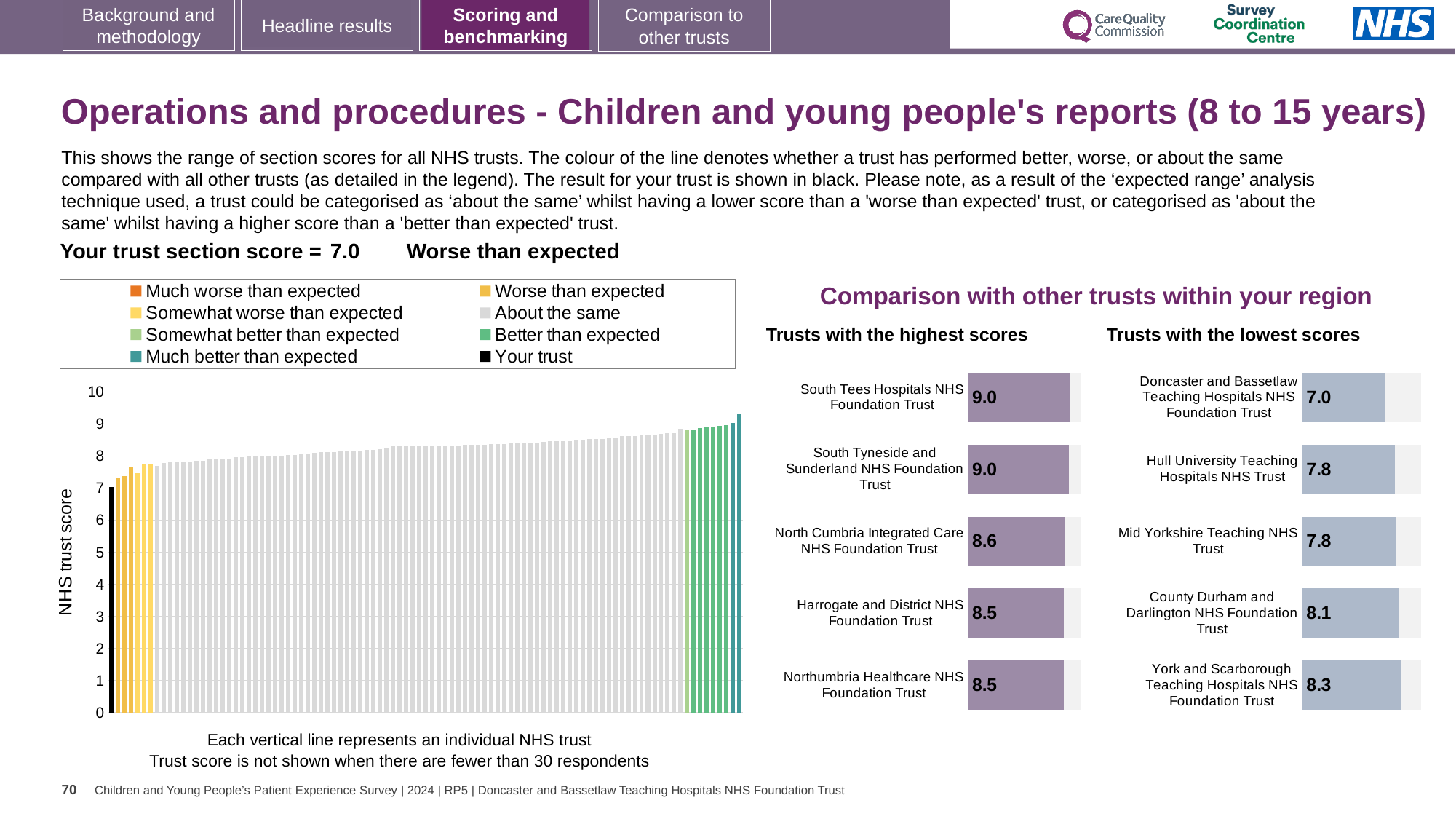
In the large chart on the left, do the trust scores rise or fall from left to right? rise In the 'Trusts with the highest scores' chart, what is the difference between the scores of South Tees Hospitals NHS Foundation Trust and North Cumbria Integrated Care NHS Foundation Trust? 0.4 Which is larger: the score for Harrogate and District NHS Foundation Trust in the 'Trusts with the highest scores' chart or the score for Hull University Teaching Hospitals NHS Trust in the 'Trusts with the lowest scores' chart? Harrogate and District NHS Foundation Trust In the large chart on the left, is the value for 'Your trust' greater or less than 8? less In the 'Trusts with the highest scores' chart, what is the score for North Cumbria Integrated Care NHS Foundation Trust? 8.6 In the 'Trusts with the lowest scores' chart, what is the difference between the scores of York and Scarborough Teaching Hospitals NHS Foundation Trust and Doncaster and Bassetlaw Teaching Hospitals NHS Foundation Trust? 1.3 In the 'Trusts with the lowest scores' chart, which trust has the highest score? York and Scarborough Teaching Hospitals NHS Foundation Trust How many entries does the legend of the large chart on the left list? 8 In the 'Trusts with the lowest scores' chart, what is the score for Hull University Teaching Hospitals NHS Trust? 7.8 In the 'Trusts with the lowest scores' chart, which trust has the lowest score? Doncaster and Bassetlaw Teaching Hospitals NHS Foundation Trust What kind of chart is the large chart on the left of the slide? bar chart How many trusts are shown in the 'Trusts with the highest scores' chart? 5